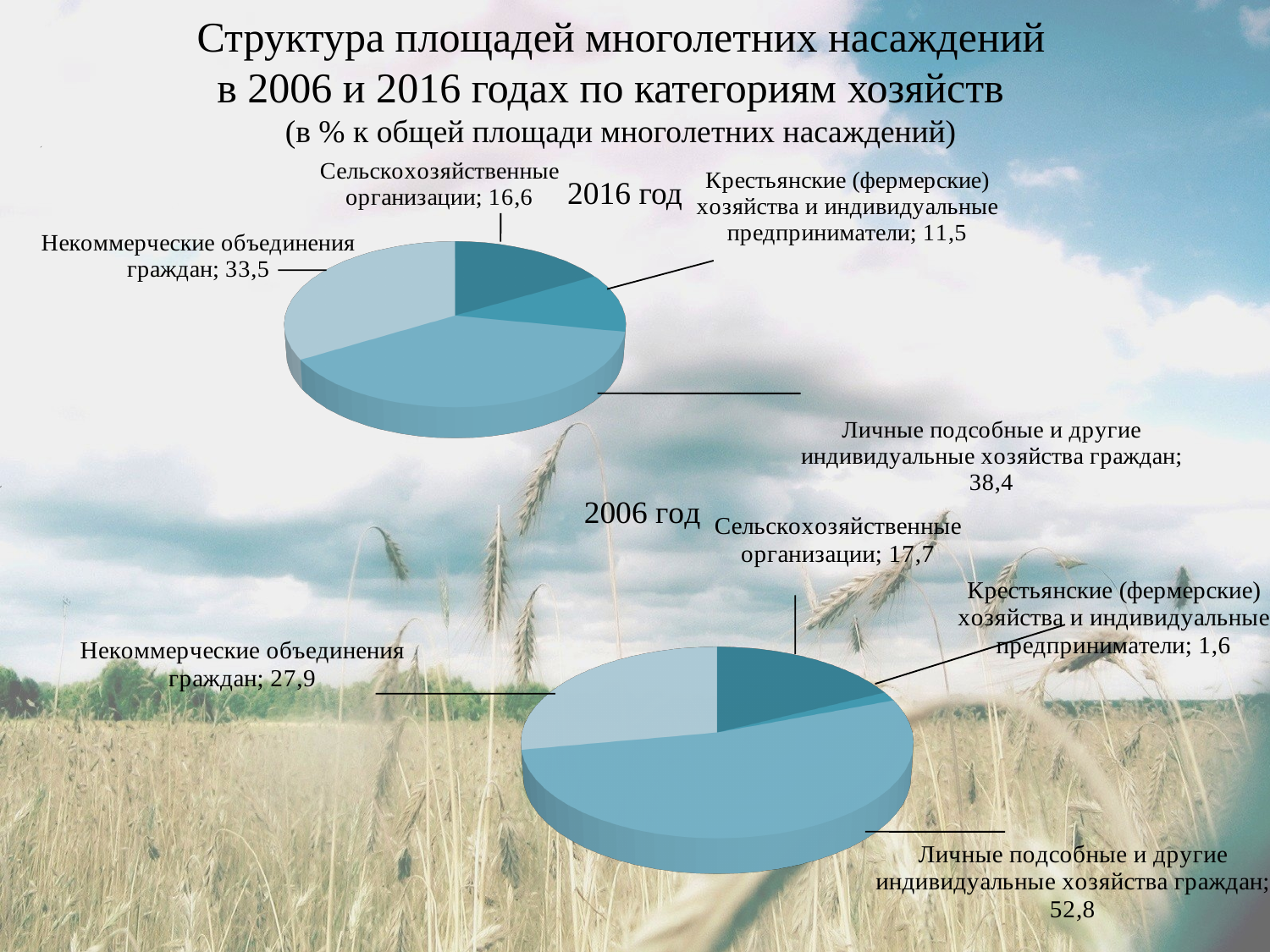
Какая доля у категории «Сельскохозяйственные организации» больше: на диаграмме «2016 год» или на диаграмме «2006 год»? 2006 год На диаграмме «2006 год» на сколько доля категории «Личные подсобные и другие индивидуальные хозяйства граждан» больше доли категории «Некоммерческие объединения граждан»? 24,9 На диаграмме «2016 год» какое значение у категории «Личные подсобные и другие индивидуальные хозяйства граждан»? 38,4 Сколько категорий показано на диаграмме «2016 год»? 4 Какого типа диаграммы представлены на слайде? Круговые диаграммы На диаграмме «2006 год» какое значение у категории «Крестьянские (фермерские) хозяйства и индивидуальные предприниматели»? 1,6 Сколько круговых диаграмм на слайде? 2 На диаграмме «2016 год» на сколько доля категории «Сельскохозяйственные организации» больше доли категории «Крестьянские (фермерские) хозяйства и индивидуальные предприниматели»? 5,1 На диаграмме «2006 год» какое значение у категории «Сельскохозяйственные организации»? 17,7 На диаграмме «2016 год» какая категория имеет наименьшую долю? Крестьянские (фермерские) хозяйства и индивидуальные предприниматели На диаграмме «2016 год» какое значение у категории «Некоммерческие объединения граждан»? 33,5 На диаграмме «2006 год» какая категория имеет наибольшую долю? Личные подсобные и другие индивидуальные хозяйства граждан